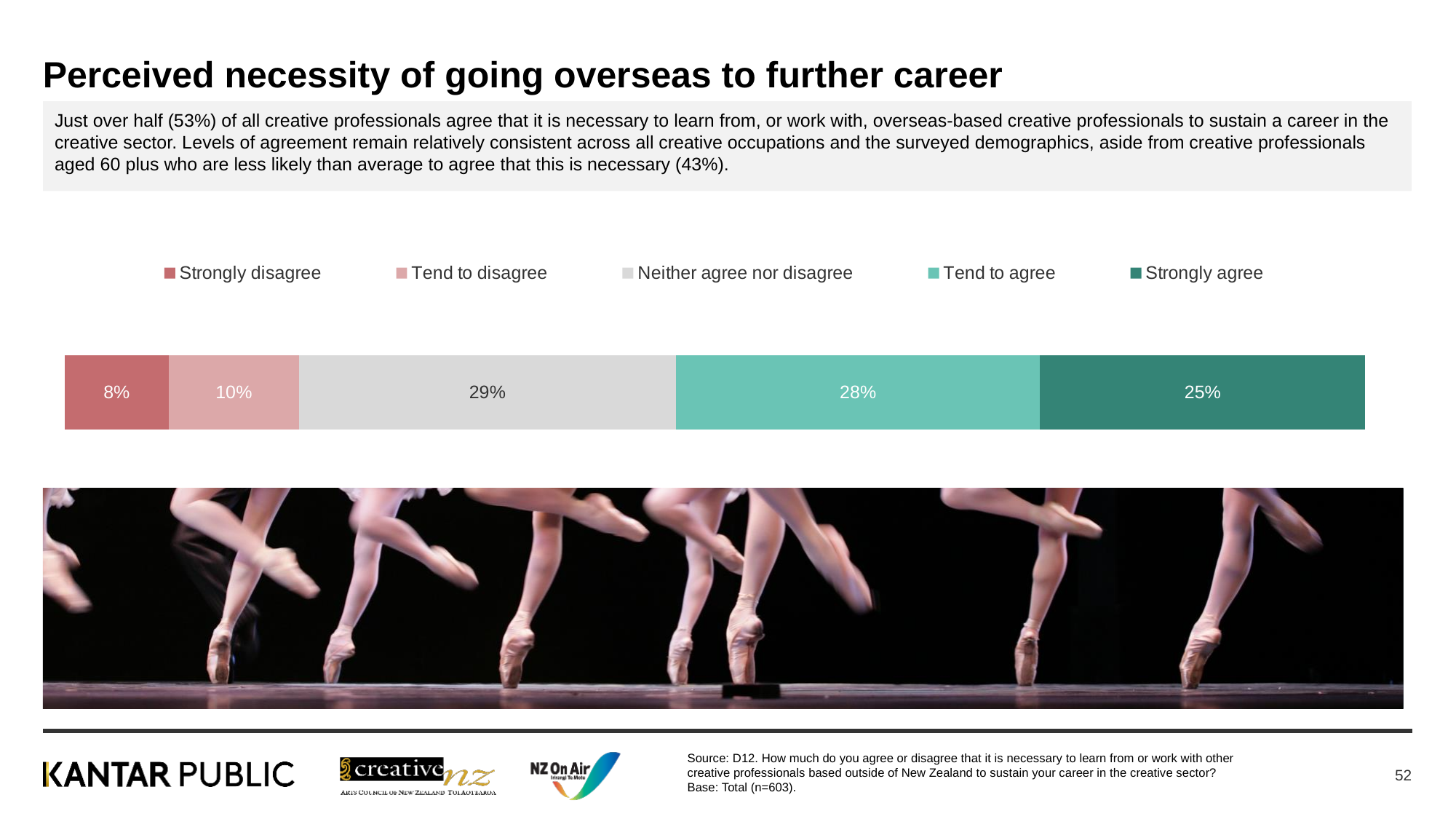
What is the difference between the 'Strongly agree' and 'Strongly disagree' percentages? 17% What percentage of respondents tend to disagree? 10% What percentage of respondents tend to agree? 28% How many response categories does the legend list? 5 Which is larger, 'Tend to agree' or 'Strongly agree'? Tend to agree What type of chart is shown on the slide? Stacked bar chart What percentage of respondents strongly agree? 25% Which response category has the largest share? Neither agree nor disagree What percentage of respondents strongly disagree? 8% What percentage of respondents neither agree nor disagree? 29% What is the combined percentage of 'Tend to agree' and 'Strongly agree'? 53% Which response category has the smallest share? Strongly disagree